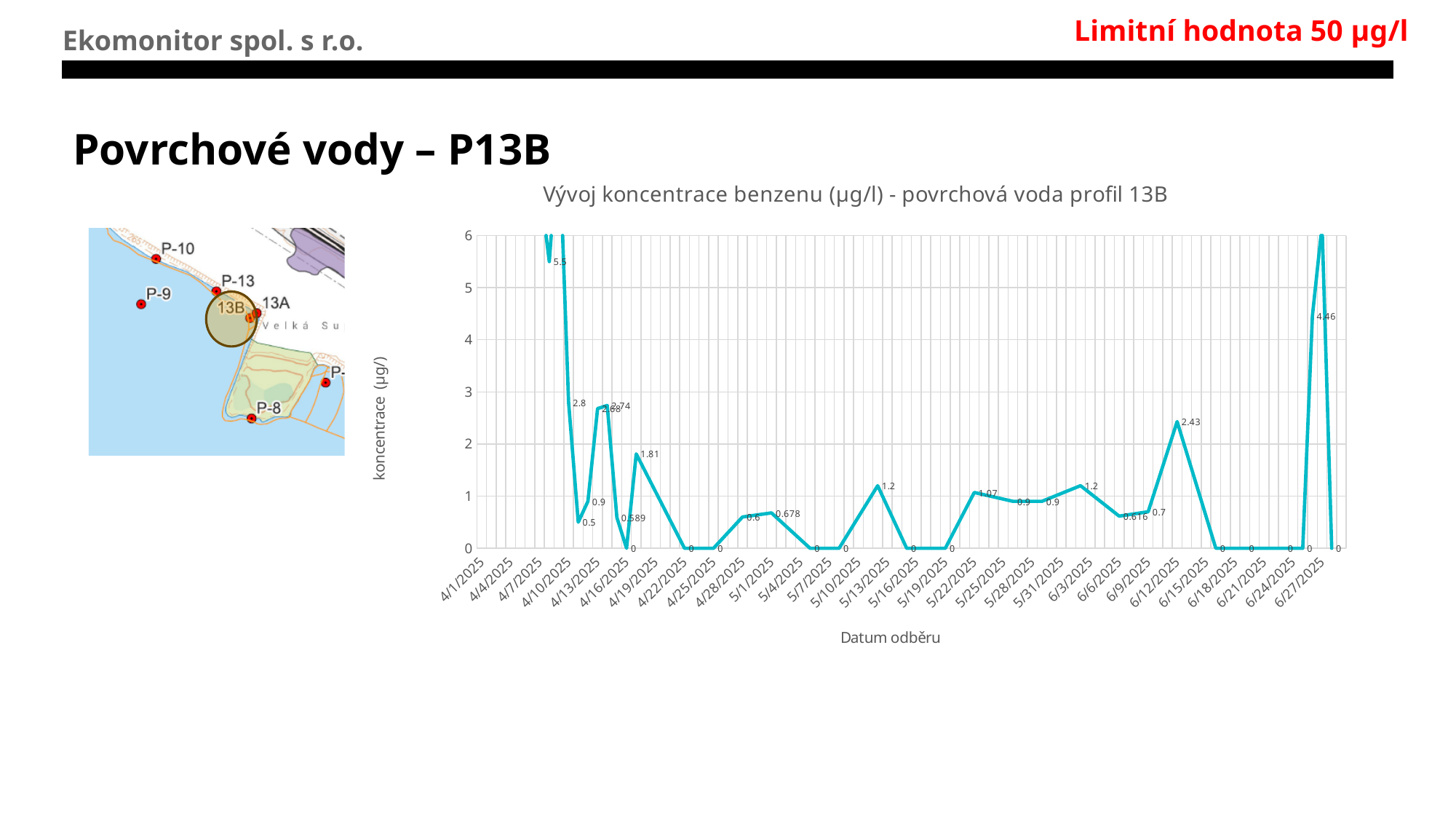
Is the value at 6/12/2025 greater or less than 2? greater What kind of chart is shown on the slide? line chart What is the benzene concentration value labelled at 4/22/2025? 0 What is the title of the chart? Vývoj koncentrace benzenu (µg/l) - povrchová voda profil 13B What is the benzene concentration value labelled at 5/22/2025? 1.07 What is the label of the x axis of the chart? Datum odběru What is the benzene concentration value labelled at 6/12/2025? 2.43